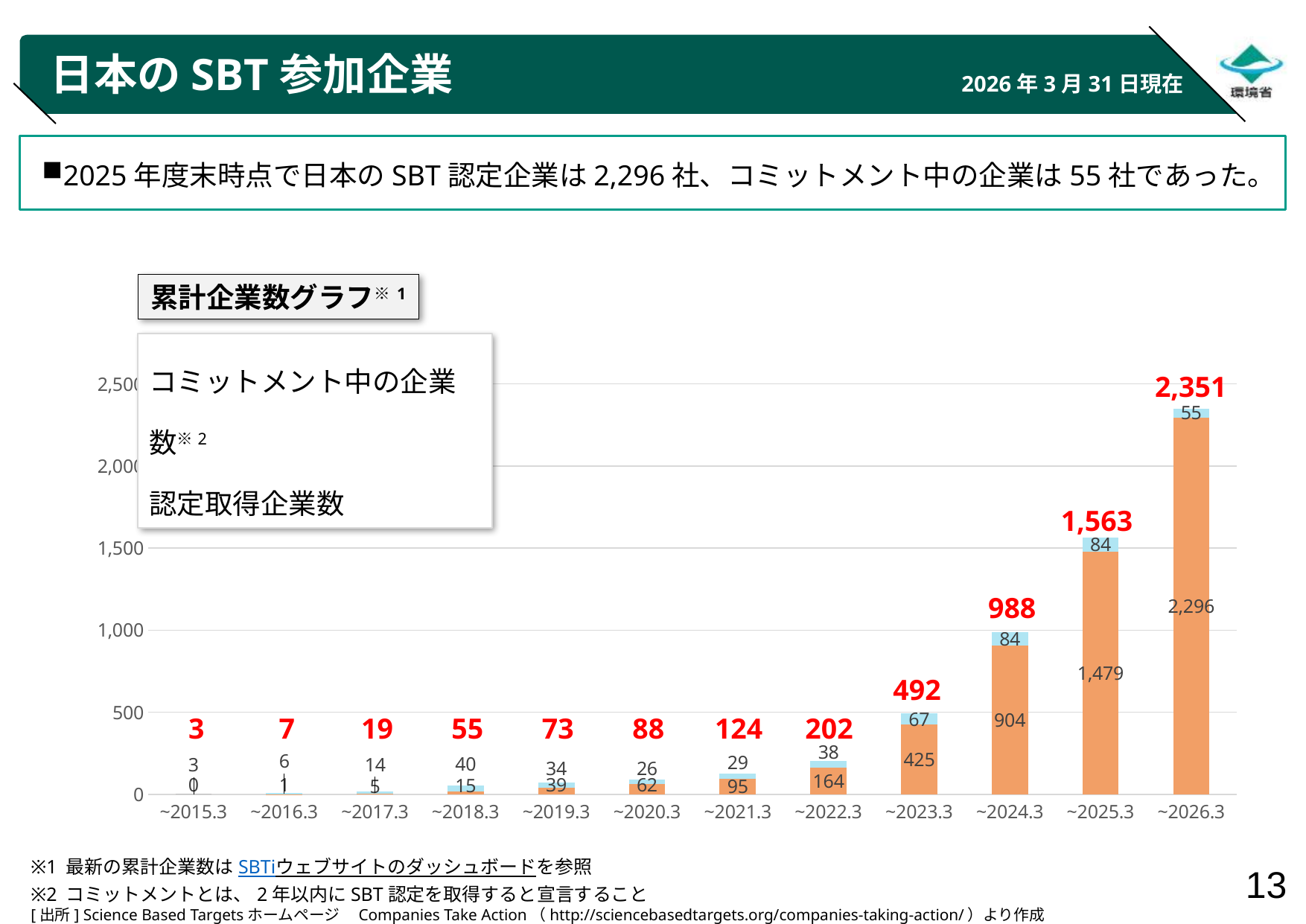
Do the totals rise or fall from ~2015.3 to ~2026.3? rise What type of chart is shown on the slide? stacked bar chart Which category has the lowest total? ~2015.3 What is the value of 認定取得企業数 for ~2022.3? 164 What is the value of コミットメント中の企業数 for ~2023.3? 67 How many series does the legend list? 2 Which category has the highest total? ~2026.3 What is the value of 認定取得企業数 for ~2025.3? 1,479 How many categories are shown on the x axis? 12 What is the difference between the totals for ~2026.3 and ~2025.3? 788 Which is larger, the 認定取得企業数 value for ~2024.3 or for ~2023.3? ~2024.3 What is the total (red label) for ~2026.3? 2,351